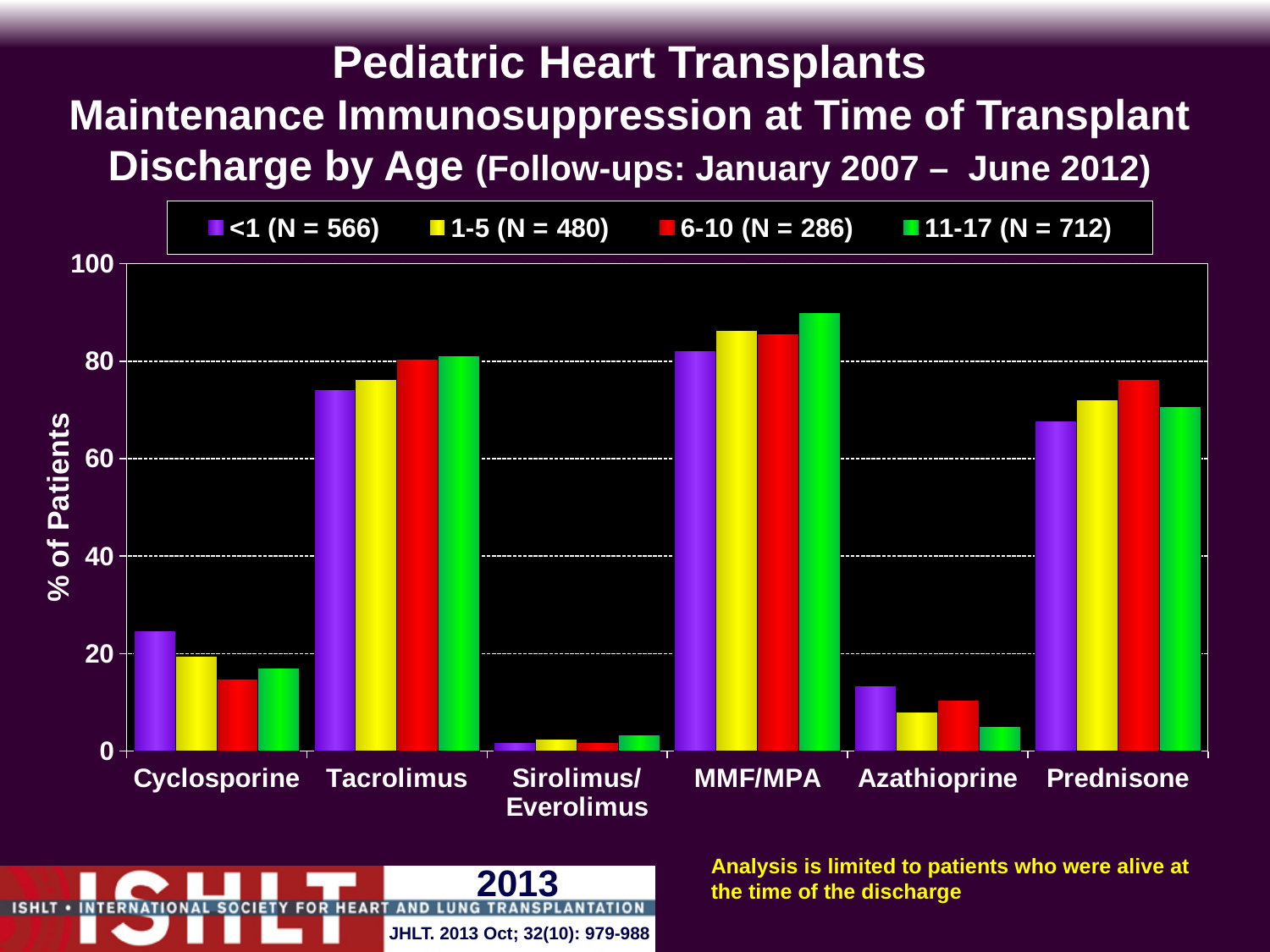
Which drug category has the highest value for the 11-17 age group? MMF/MPA Is the value for Prednisone in the 6-10 age group greater or less than 60? greater For Prednisone, which age group has the larger value: <1 or 6-10? 6-10 Which drug category has the lowest value for the <1 age group? Sirolimus/Everolimus What kind of chart is shown on the slide? bar chart Is the value for Cyclosporine in the <1 age group greater or less than 20? greater According to the legend, what is the N for the 6-10 age group? 286 Is the value for Tacrolimus in the <1 age group greater or less than 80? less How many age-group series does the legend list? 4 How many drug categories are shown on the x axis? 6 For Azathioprine, which age group has the larger value: <1 or 11-17? <1